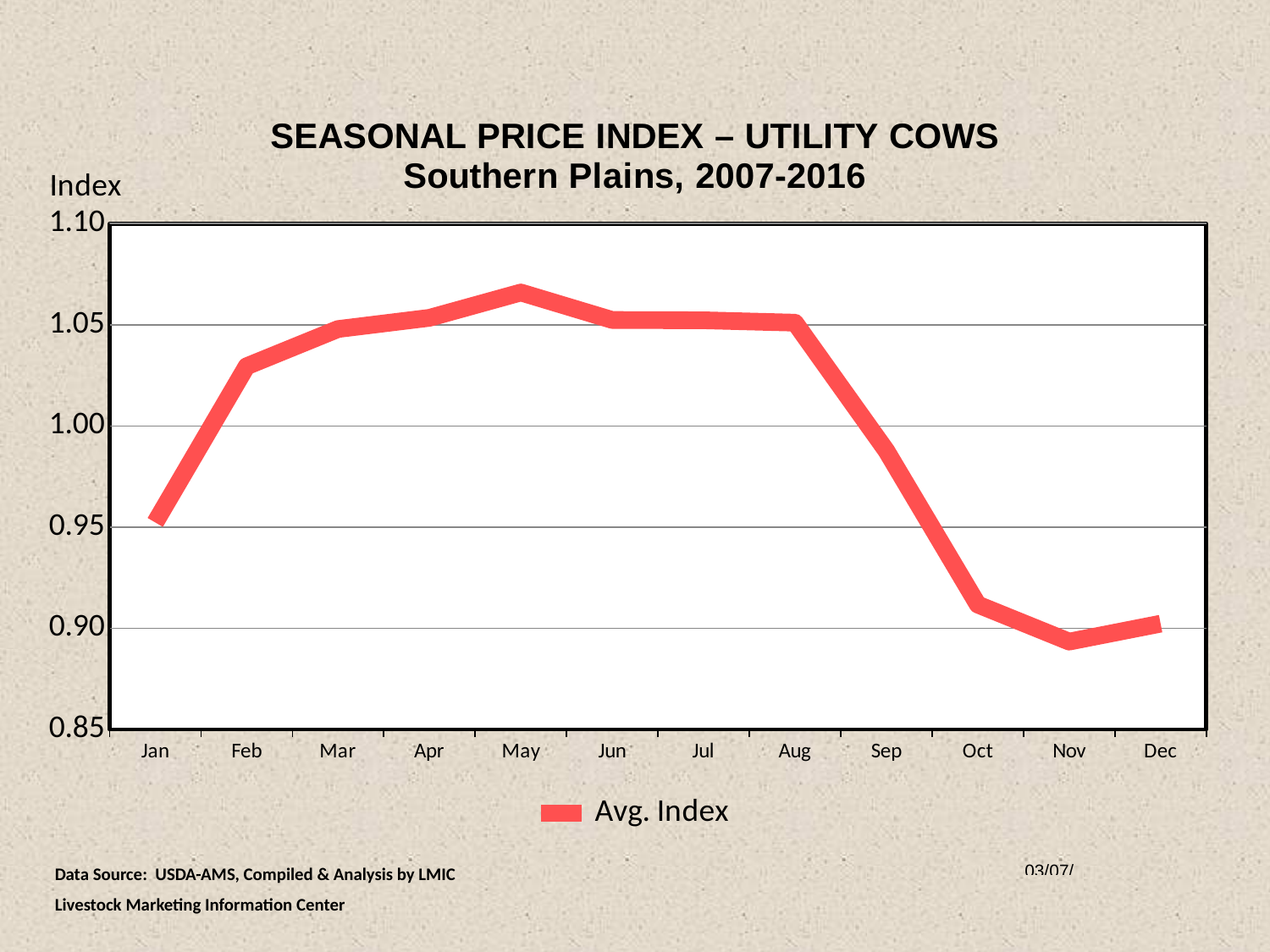
Is the value for May greater or less than 1.05? greater Is the value for Jan greater or less than 1.00? less What kind of chart is shown on the slide? line chart How many months are plotted along the x axis? 12 Do the values rise or fall from Aug to Nov? fall Is the value for Feb greater or less than 1.00? greater Which month has the lowest Avg. Index value? Nov What is the name of the series shown in the legend? Avg. Index How many series does the legend list? 1 Which is larger, the value for Feb or the value for Oct? Feb Which month has the highest Avg. Index value? May